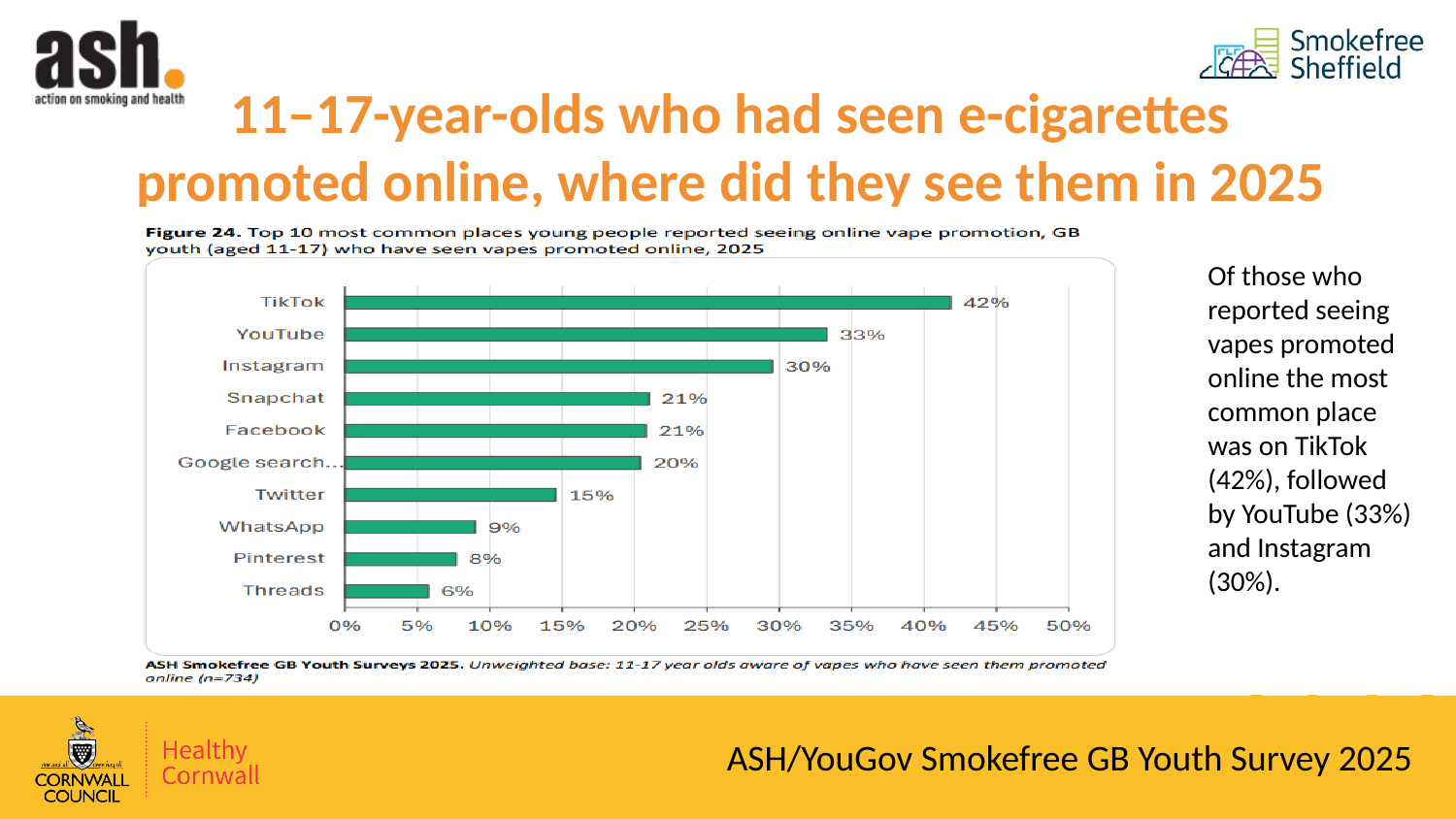
What percentage is shown for Twitter? 15% What kind of chart is shown on the slide? Bar chart Which platform has the highest value in the chart? TikTok Which platform has the lowest value in the chart? Threads Which has a larger value, Instagram or Snapchat? Instagram How many platforms are shown in the chart? 10 Is the value for Google search greater or less than 25%? less What is the value shown for YouTube? 33% What is the difference between the values for WhatsApp and Pinterest? 1% What percentage of 11-17-year-olds reported seeing vape promotion on TikTok? 42% What is the difference between the values for TikTok and Instagram? 12% What is the figure number given in the chart's caption? Figure 24